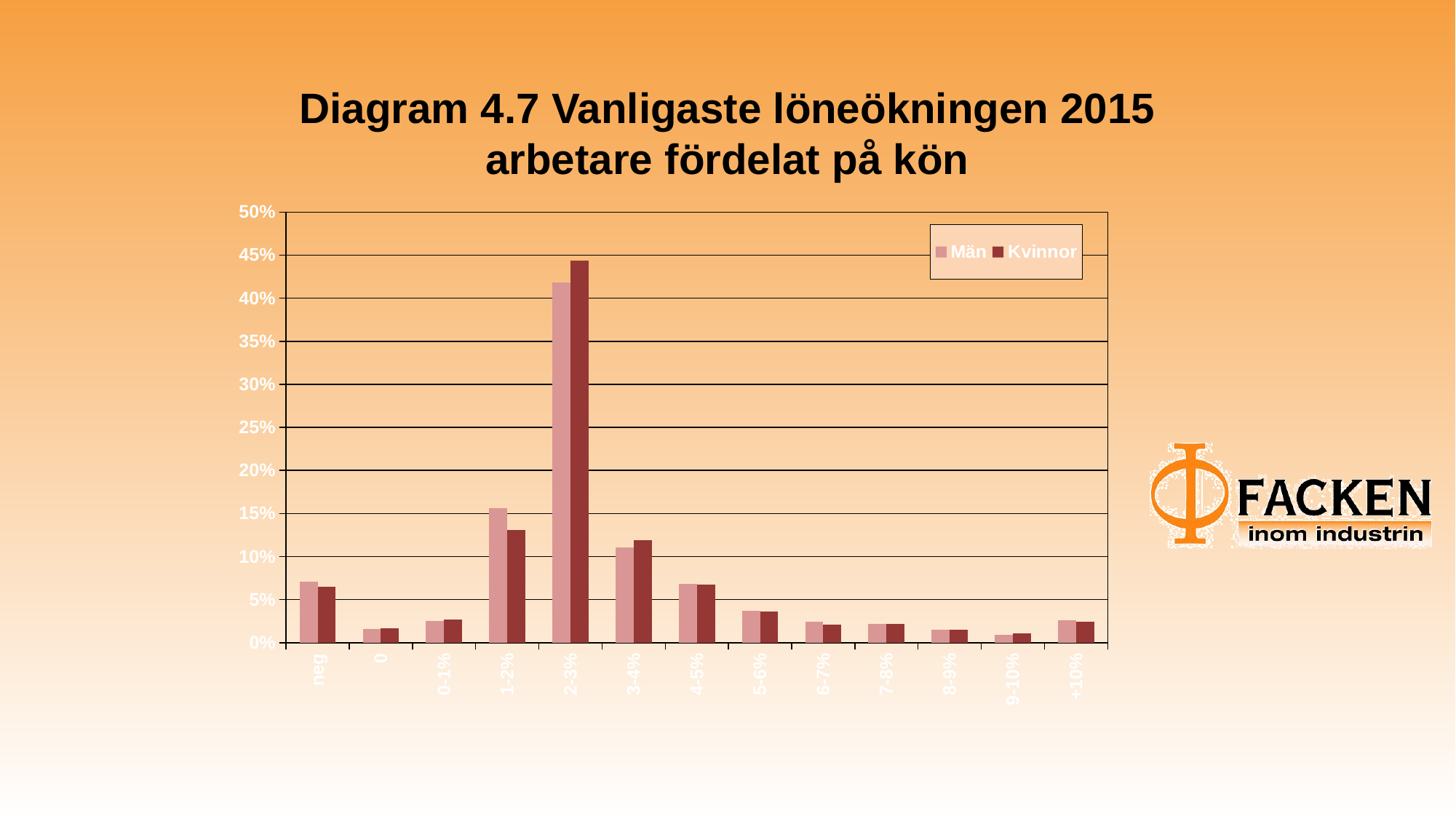
Which category has the lowest value for Män? 9-10% Is the value for Män in the neg category greater or less than 5%? greater How many categories are shown on the x axis? 13 Is the value for Kvinnor in the 2-3% category greater or less than 40%? greater How many series does the legend list? 2 What kind of chart is shown on the slide? bar chart Which category has the highest value for Män? 2-3% In the 1-2% category, which series has the larger value, Män or Kvinnor? Män In the 2-3% category, which series has the larger value, Män or Kvinnor? Kvinnor What are the two series named in the legend? Män and Kvinnor Which category has the highest value for Kvinnor? 2-3% Is the value for Kvinnor in the 1-2% category greater or less than 15%? less